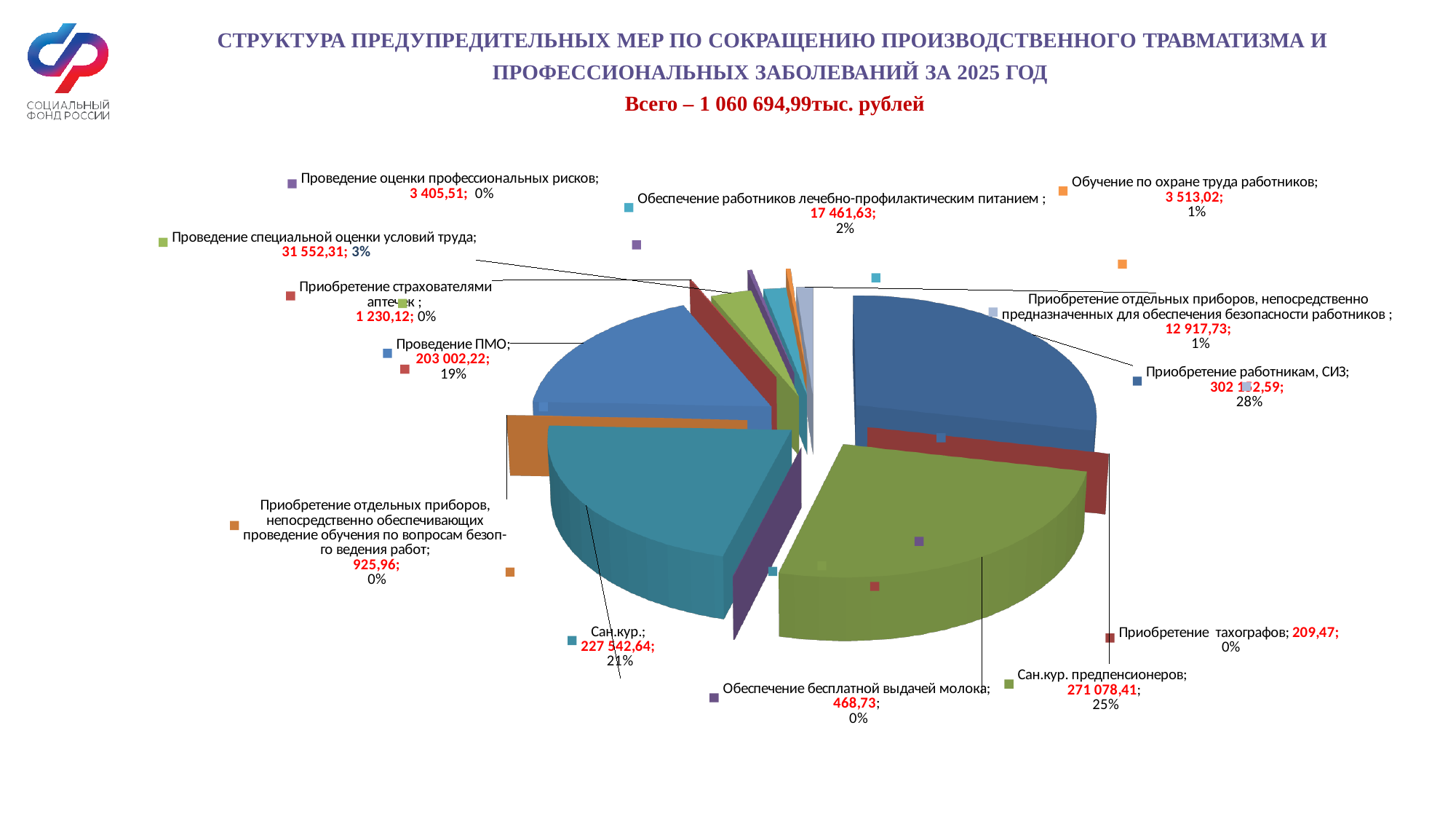
What is the value for Приобретение тахографов? 209,47 How many categories (slices) does the pie chart have? 13 What share of the pie does Приобретение работникам СИЗ represent? 28% What is the difference between Сан.кур. предпенсионеров and Сан.кур.? 43 535,77 Which category has the smallest value? Приобретение тахографов What is the value for Сан.кур. предпенсионеров? 271 078,41 What share of the pie does Сан.кур. represent? 21% What kind of chart is shown on the slide? Pie chart What is the value for Проведение специальной оценки условий труда? 31 552,31 What is the value for Проведение ПМО? 203 002,22 Which category has the largest share of the pie? Приобретение работникам СИЗ Which is larger: Сан.кур. предпенсионеров or Проведение ПМО? Сан.кур. предпенсионеров